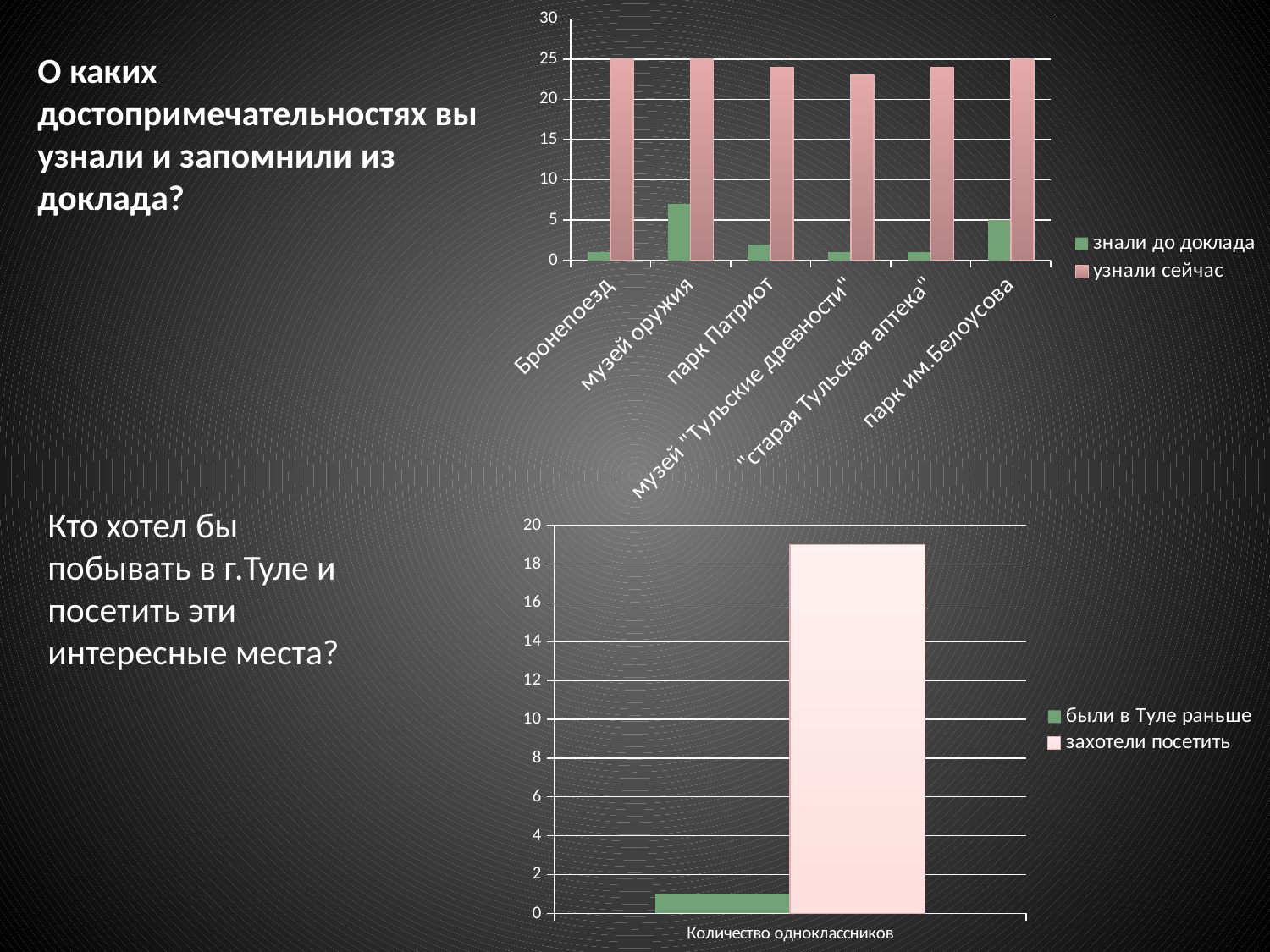
In the top chart, is the value for 'знали до доклада' for 'Бронепоезд' greater or less than 5? less In the top chart, which category has the highest value for 'знали до доклада'? музей оружия What kind of chart is the bottom chart on the slide? bar chart In the bottom chart, is the value for 'захотели посетить' greater or less than 18? greater In the top chart, which series is shown in green? знали до доклада In the bottom chart, which series has the larger value: 'были в Туле раньше' or 'захотели посетить'? захотели посетить In the top chart, for 'парк Патриот', which series has the larger value: 'знали до доклада' or 'узнали сейчас'? узнали сейчас How many series does the legend of the bottom chart list? 2 How many categories are shown on the x axis of the top chart? 6 How many series does the legend of the top chart list? 2 What kind of chart is the top chart on the slide? bar chart In the top chart, is the value for 'узнали сейчас' for 'музей "Тульские древности"' greater or less than 20? greater